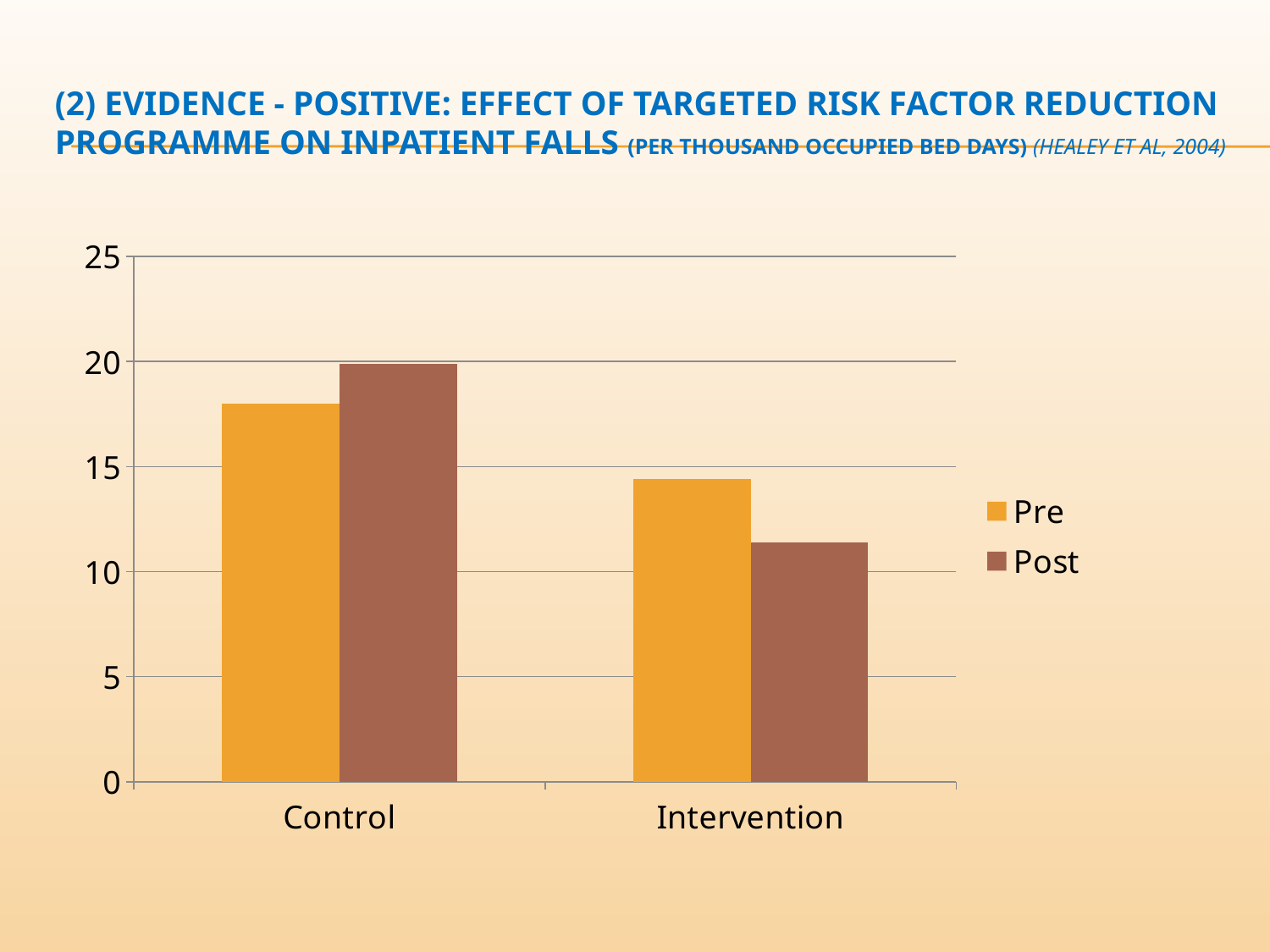
Which category and series has the highest bar? Control, Post Is the Post value for Intervention greater or less than 15? less How many series does the legend list? 2 For Control, which is larger, the Pre value or the Post value? Post For Intervention, which is larger, the Pre value or the Post value? Pre Is the Pre value for Intervention greater or less than 10? greater What kind of chart is shown on the slide? bar chart How many categories are shown on the x axis? 2 Which category and series has the lowest bar? Intervention, Post What are the two entries listed in the legend? Pre and Post Is the Pre value for Control greater or less than 15? greater